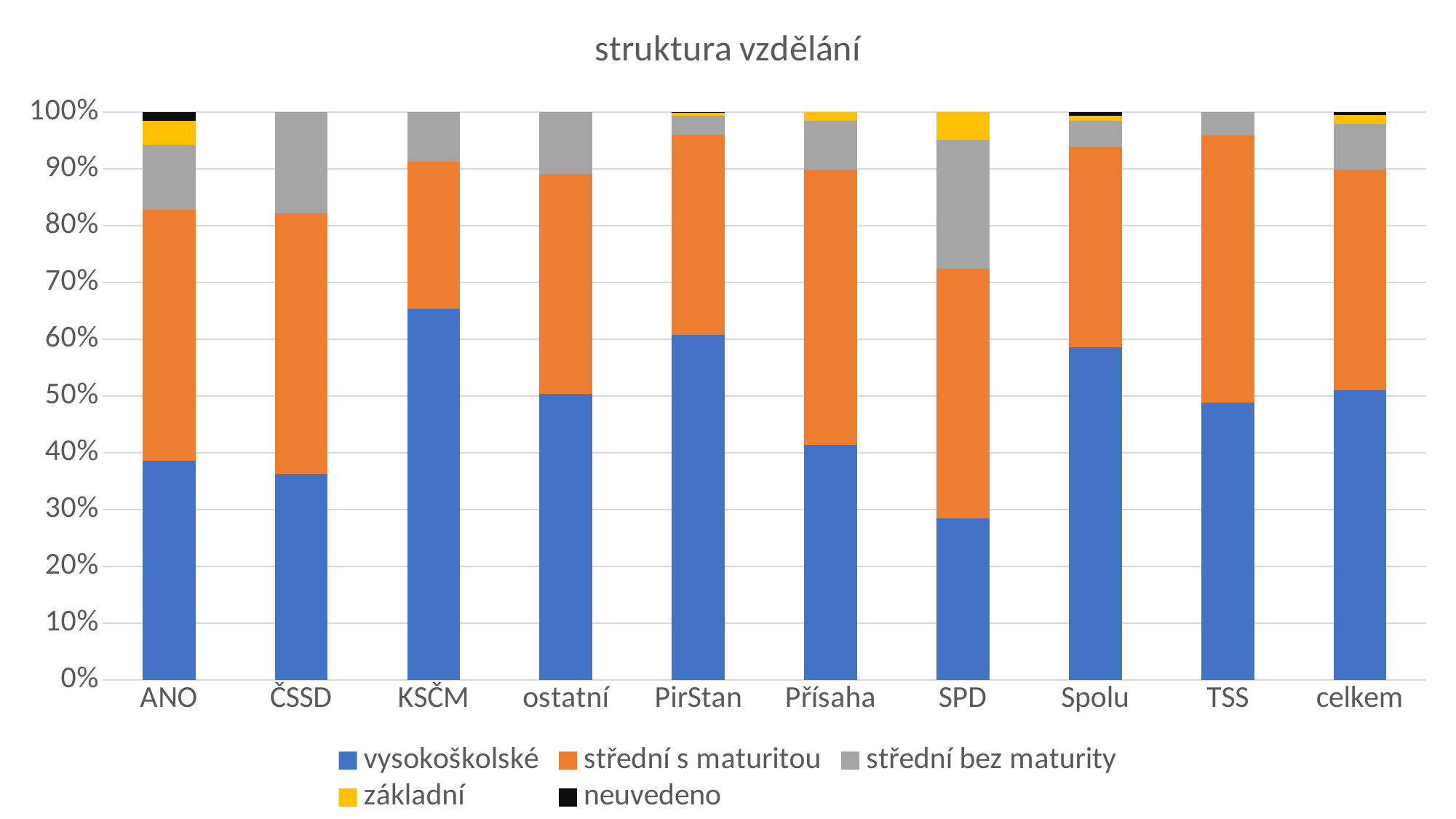
What is the title of the chart? struktura vzdělání Is the vysokoškolské share for KSČM greater or less than 60%? greater Is the vysokoškolské share for SPD greater or less than 30%? less What kind of chart is shown on the slide? stacked bar chart How many series does the legend list? 5 How many categories are shown on the x axis of the chart? 10 Which has a larger vysokoškolské share, SPD or Spolu? Spolu Is the vysokoškolské share for ANO greater or less than 40%? less What is the total of the stacked bar for celkem? 100% Which category has the smallest share of vysokoškolské? SPD Which has a larger vysokoškolské share, KSČM or ČSSD? KSČM Which category has the largest share of vysokoškolské? KSČM